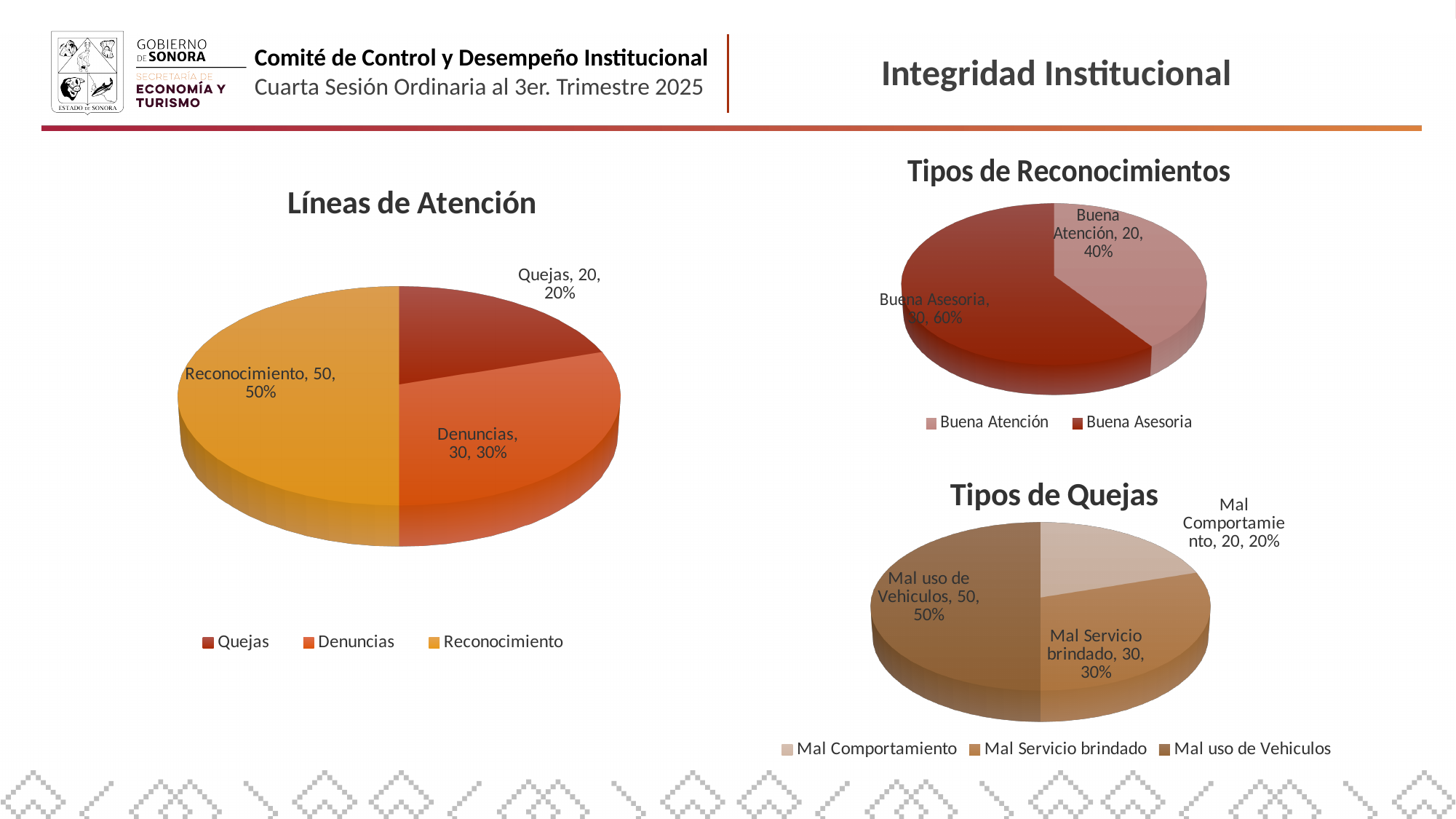
What kind of chart is 'Líneas de Atención'? Pie chart In the 'Tipos de Reconocimientos' chart, what is the value for Buena Asesoria? 30 How many slices does the 'Tipos de Quejas' chart have? 3 In the 'Tipos de Quejas' chart, which is larger, Mal uso de Vehiculos or Mal Comportamiento? Mal uso de Vehiculos In the 'Líneas de Atención' chart, what share of the pie does Quejas represent? 20% In the 'Líneas de Atención' chart, what is the value for Denuncias? 30 In the 'Líneas de Atención' chart, which category has the largest slice? Reconocimiento In the 'Tipos de Quejas' chart, what is the value for Mal Servicio brindado? 30 In the 'Tipos de Reconocimientos' chart, which category has the smallest slice? Buena Atención In the 'Tipos de Reconocimientos' chart, what share of the pie does Buena Atención represent? 40% How many categories does the legend of the 'Líneas de Atención' chart list? 3 In the 'Líneas de Atención' chart, what is the difference between the values for Reconocimiento and Quejas? 30